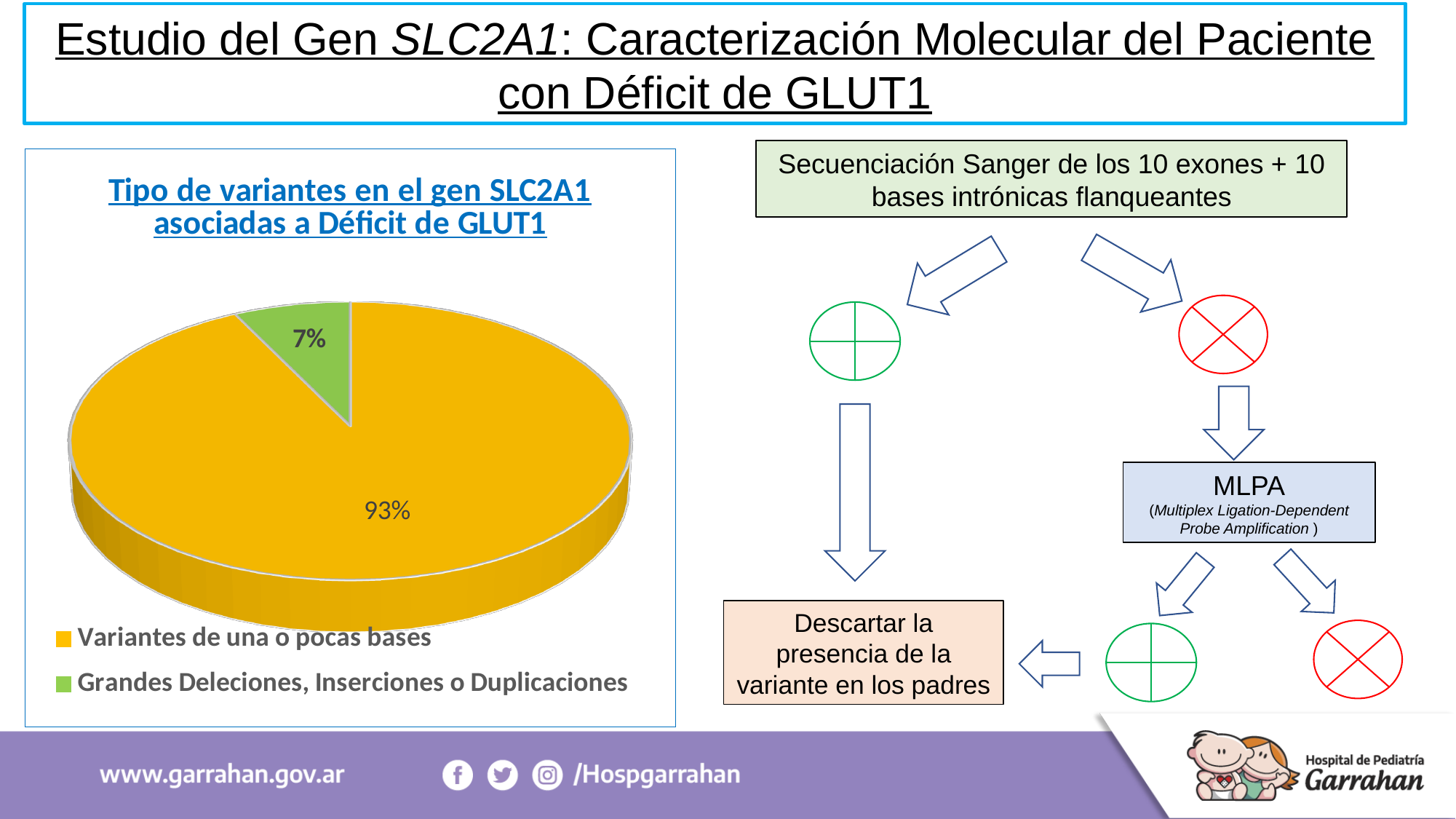
What percentage of the pie corresponds to 'Grandes Deleciones, Inserciones o Duplicaciones'? 7% Which is larger: the share for 'Variantes de una o pocas bases' or for 'Grandes Deleciones, Inserciones o Duplicaciones'? Variantes de una o pocas bases What share of the pie does the green slice represent? 7% What colour is the slice for 'Grandes Deleciones, Inserciones o Duplicaciones'? Green What is the title of the pie chart? Tipo de variantes en el gen SLC2A1 asociadas a Déficit de GLUT1 How many categories does the pie chart show? 2 What kind of chart is shown on the slide? Pie chart How many entries does the legend of the pie chart list? 2 Which category has the smallest share of the pie? Grandes Deleciones, Inserciones o Duplicaciones What is the difference in percentage points between 'Variantes de una o pocas bases' and 'Grandes Deleciones, Inserciones o Duplicaciones'? 86 percentage points What percentage of the pie corresponds to 'Variantes de una o pocas bases'? 93% Which category has the largest share of the pie? Variantes de una o pocas bases